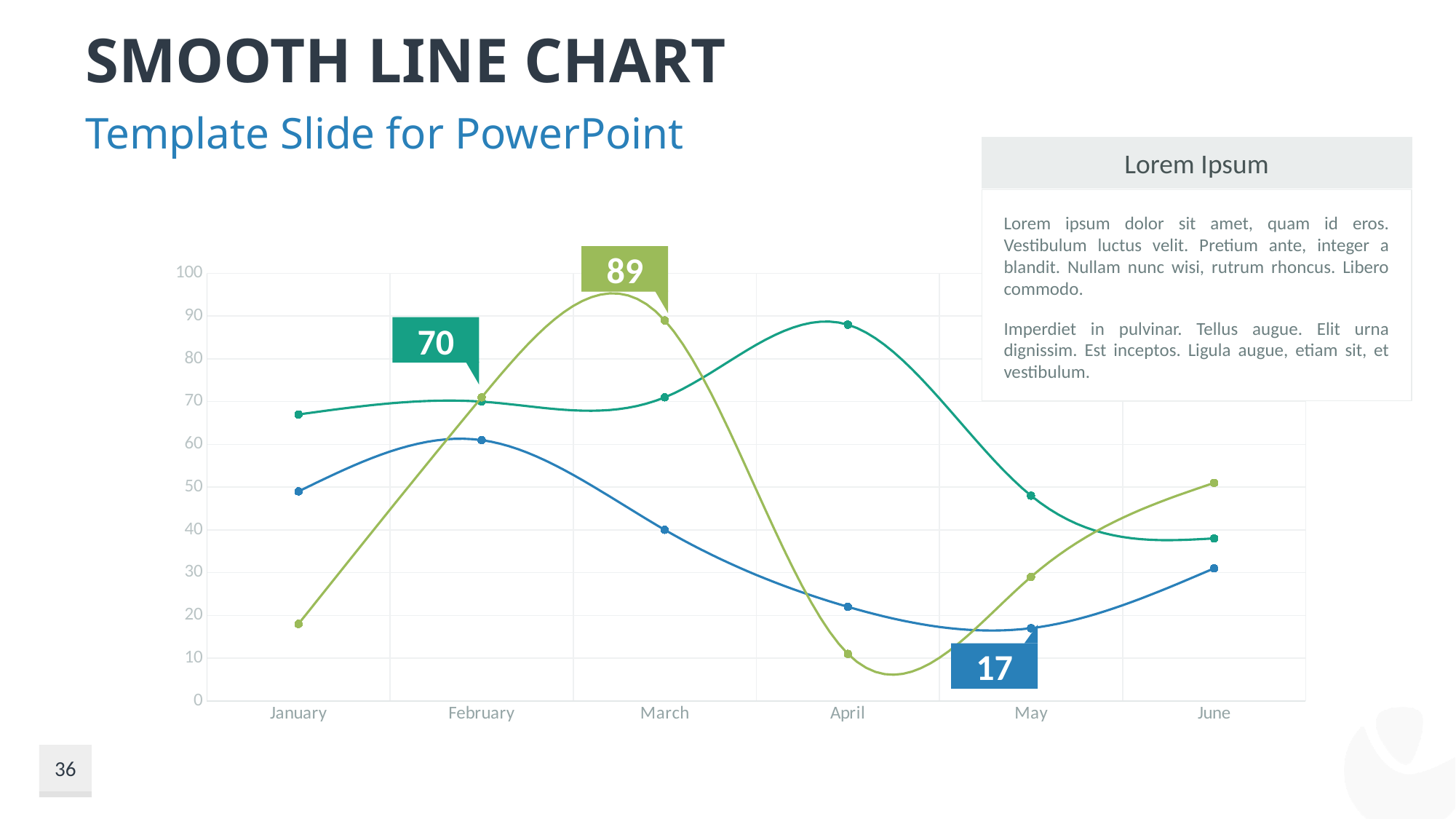
Is the value of the teal line in April greater or less than 80? greater What is the labelled value of the blue line in May? 17 In January, which line has the higher value, the blue line or the teal line? the teal line What is the labelled value of the light green line in March? 89 In which month does the light green line reach its lowest value? April How many months are shown on the x axis of the chart? 6 What is the title of the slide containing the chart? SMOOTH LINE CHART Is the value of the light green line in April greater or less than 20? less Does the blue line rise or fall from February to May? fall What kind of chart is shown on the slide? line chart What is the labelled value of the teal line in February? 70 In which month does the light green line reach its highest value? March